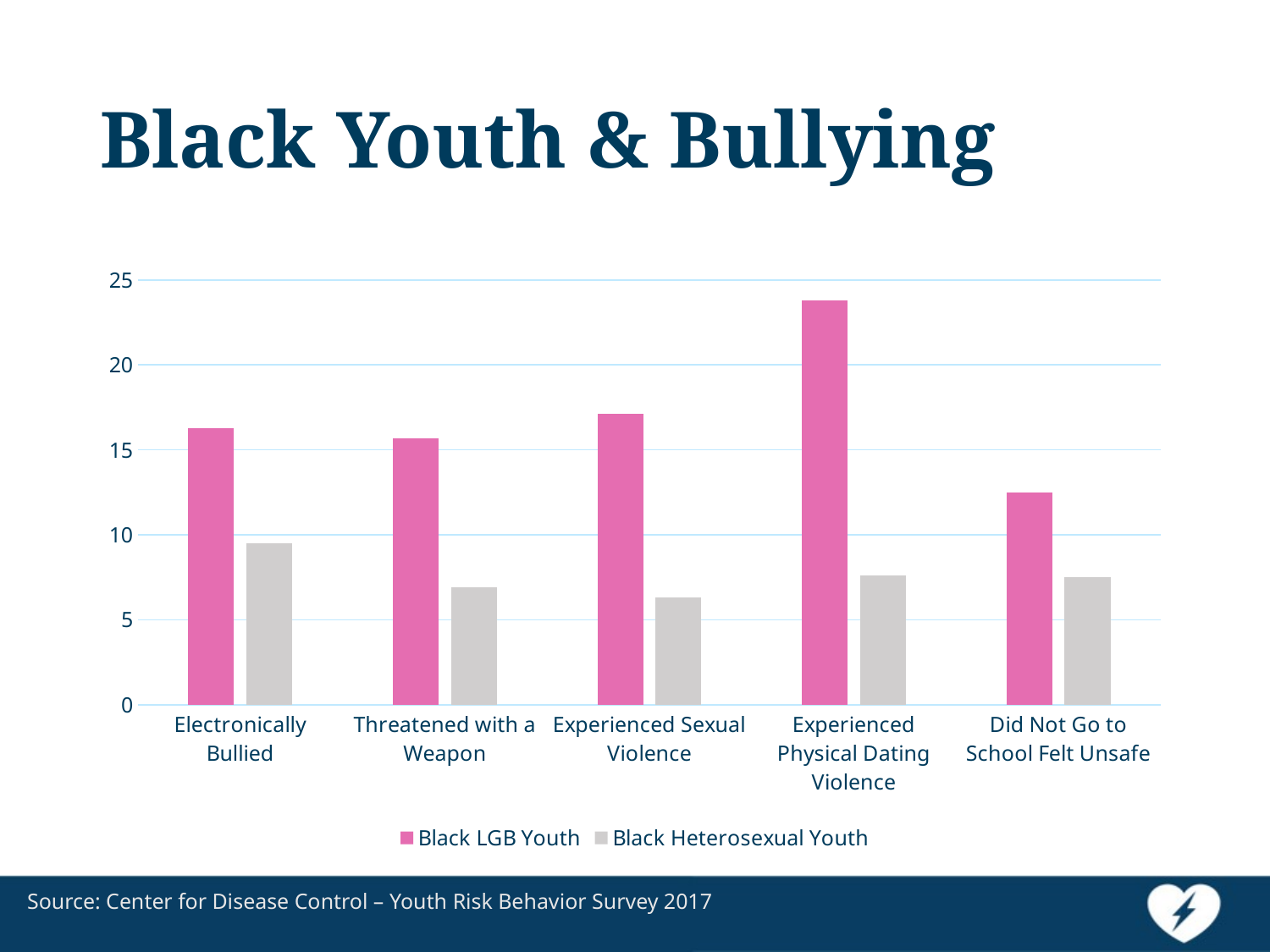
For Experienced Sexual Violence, which series has the larger value, Black LGB Youth or Black Heterosexual Youth? Black LGB Youth How many series does the legend list? 2 Is the value for Black LGB Youth in Experienced Physical Dating Violence greater or less than 20? greater Which category has the lowest value for Black LGB Youth? Did Not Go to School Felt Unsafe What kind of chart is shown on the slide? bar chart Is the value for Black Heterosexual Youth in Electronically Bullied greater or less than 10? less Is the value for Black Heterosexual Youth in Threatened with a Weapon greater or less than 5? greater Which category has the highest value for Black Heterosexual Youth? Electronically Bullied What colour are the bars for Black LGB Youth? pink How many categories are shown on the x axis of the chart? 5 Which category has the highest value for Black LGB Youth? Experienced Physical Dating Violence